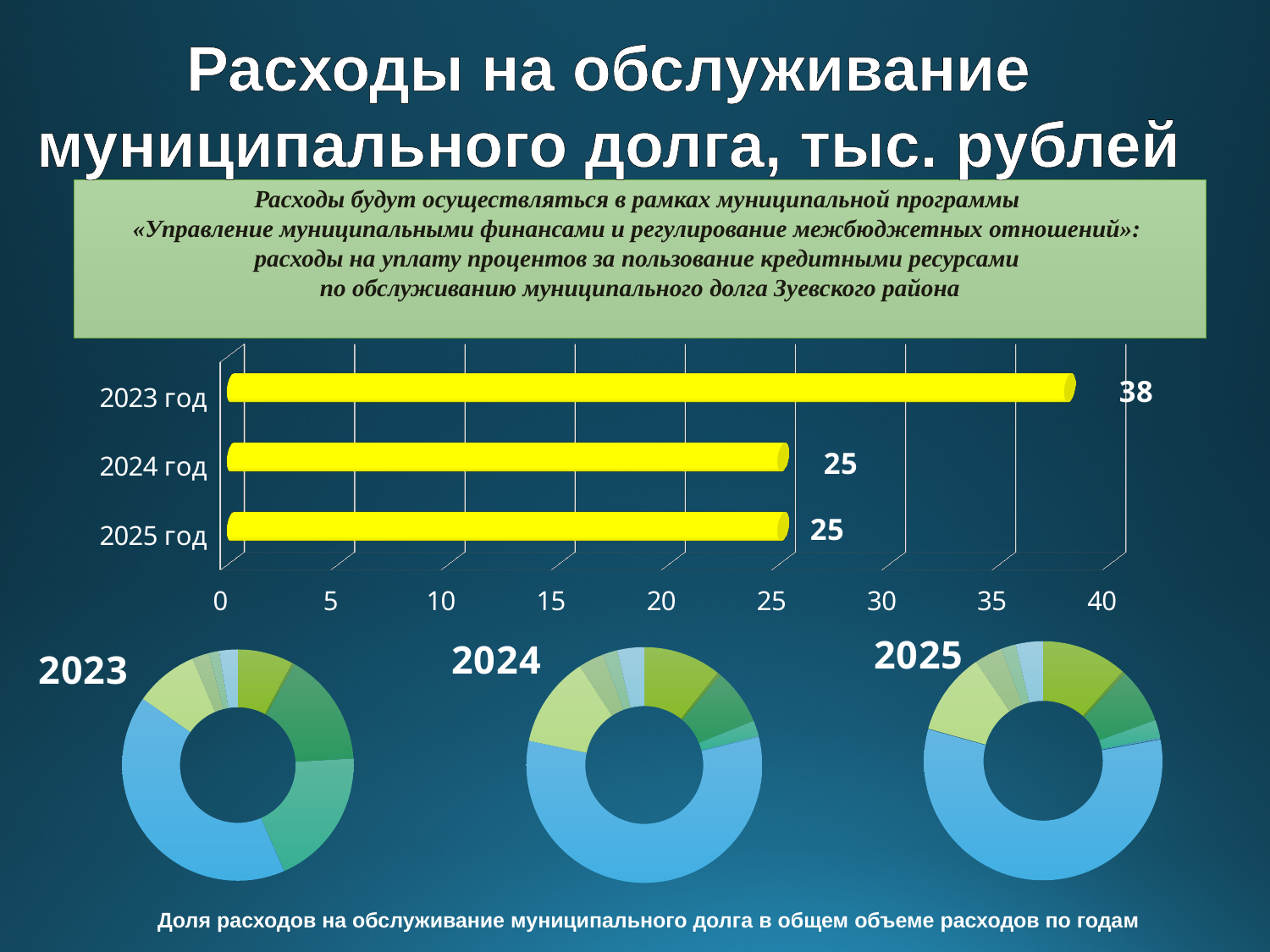
In the bar chart, is the value for 2024 год greater or less than 30? less In the bar chart, do the values rise or fall from 2023 год to 2025 год? fall How many categories (years) are shown in the bar chart? 3 In the bar chart, what is the value for 2025 год? 25 What kind of chart is the chart at the top of the slide showing values by year? bar chart In the bar chart, what is the difference between the values for 2023 год and 2024 год? 13 In the bar chart, is the value for 2023 год greater or less than 35? greater In the bar chart, what is the value for 2023 год? 38 In the bar chart, which is larger, the value for 2023 год or the value for 2025 год? 2023 год In the bar chart, what is the value for 2024 год? 25 What colour are the bars in the bar chart? yellow In the bar chart, which year has the highest value? 2023 год